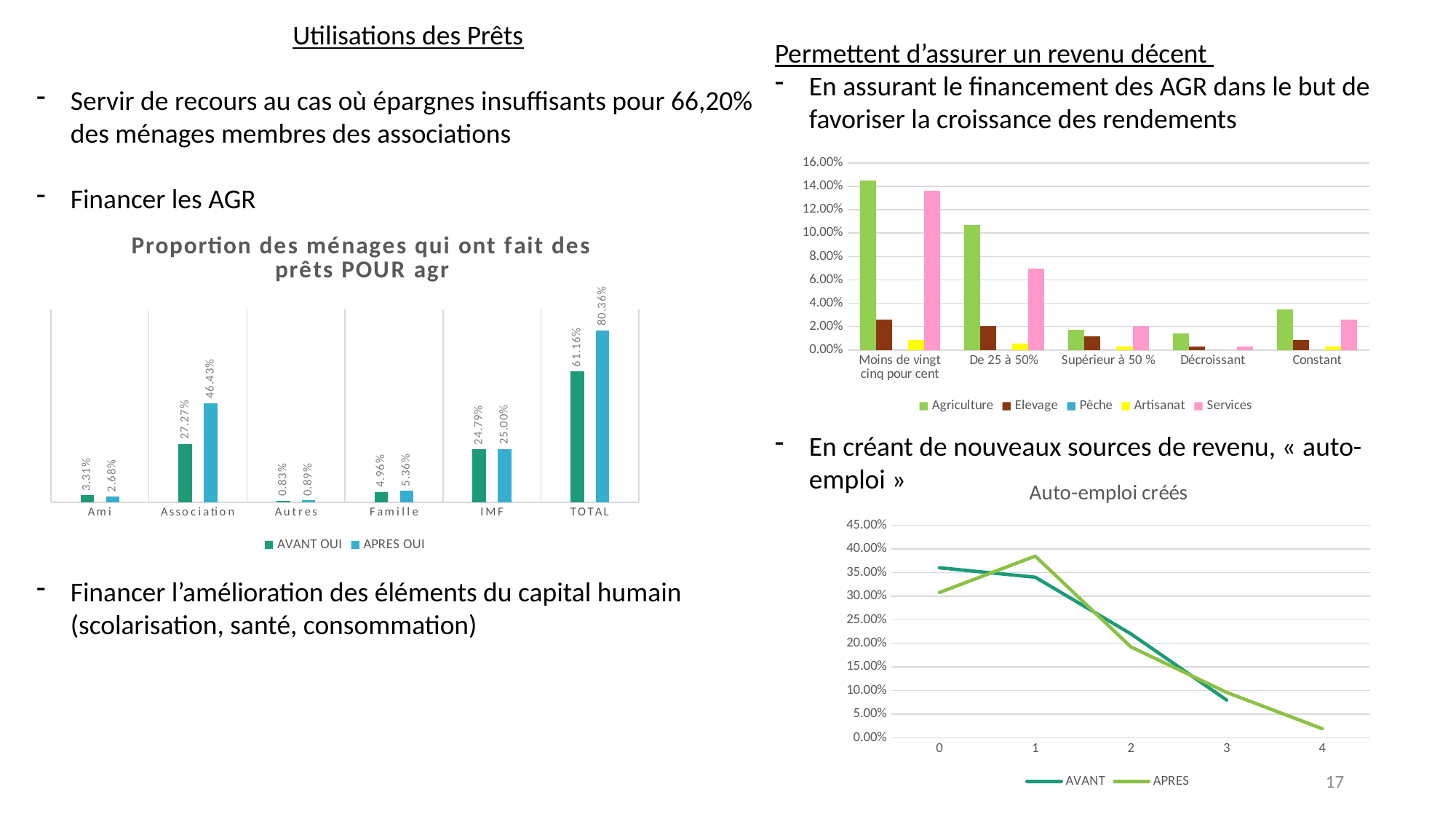
In the untitled bar chart at the top right of the slide, which series has the highest value for 'Constant'? Agriculture In the chart 'Auto-emploi créés', does the APRES series rise or fall from x = 1 to x = 4? fall In the chart 'Proportion des ménages qui ont fait des prêts POUR agr', which category has the lowest APRES OUI value? Autres In the chart 'Proportion des ménages qui ont fait des prêts POUR agr', what is the APRES OUI value for Association? 46.43% In the chart 'Proportion des ménages qui ont fait des prêts POUR agr', what is the AVANT OUI value for IMF? 24.79% In the chart 'Proportion des ménages qui ont fait des prêts POUR agr', which is larger for Famille: AVANT OUI or APRES OUI? APRES OUI In the chart 'Proportion des ménages qui ont fait des prêts POUR agr', excluding TOTAL, which category has the highest AVANT OUI value? Association In the chart 'Proportion des ménages qui ont fait des prêts POUR agr', what is the difference between the APRES OUI and AVANT OUI values for TOTAL? 19.20% In the untitled bar chart at the top right of the slide, how many series does the legend list? 5 How many series does the legend of the chart 'Proportion des ménages qui ont fait des prêts POUR agr' list? 2 What kind of chart is 'Auto-emploi créés'? line chart In the untitled bar chart at the top right of the slide, is the Services value for 'De 25 à 50%' greater or less than 6.00%? greater